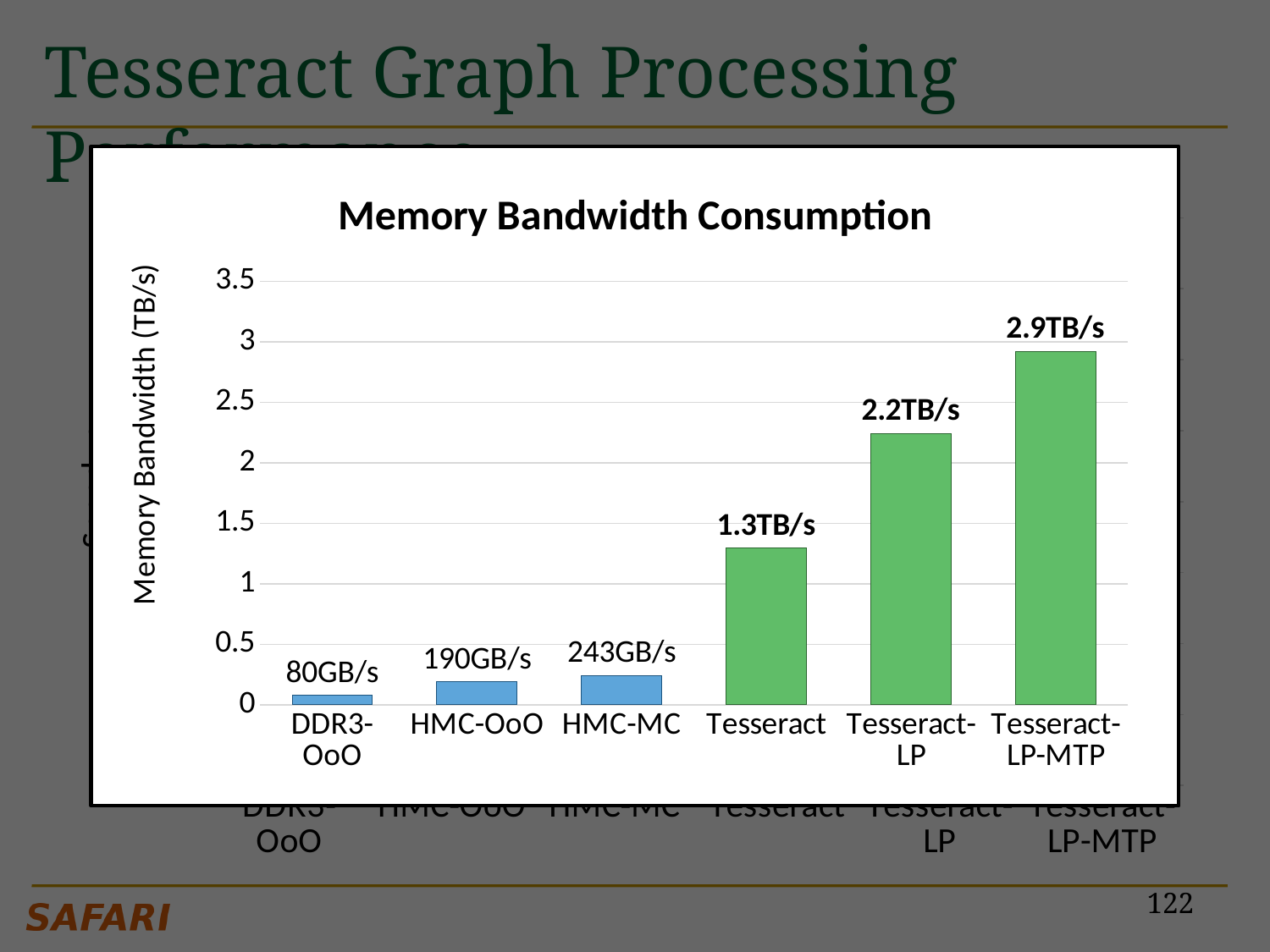
What is the title of the chart? Memory Bandwidth Consumption What is the memory bandwidth consumption for Tesseract-LP-MTP? 2.9TB/s Is the value for Tesseract-LP greater or less than 2 TB/s? greater Which category has the lowest memory bandwidth consumption? DDR3-OoO Which category has the highest memory bandwidth consumption? Tesseract-LP-MTP How many categories are shown on the x axis? 6 What kind of chart is shown on the slide? bar chart What is the difference in memory bandwidth between Tesseract-LP-MTP and Tesseract-LP? 0.7TB/s What is the difference in memory bandwidth between HMC-MC and HMC-OoO? 53GB/s Which has higher memory bandwidth consumption, Tesseract or HMC-OoO? Tesseract What is the memory bandwidth consumption for HMC-MC? 243GB/s What is the memory bandwidth consumption for DDR3-OoO? 80GB/s